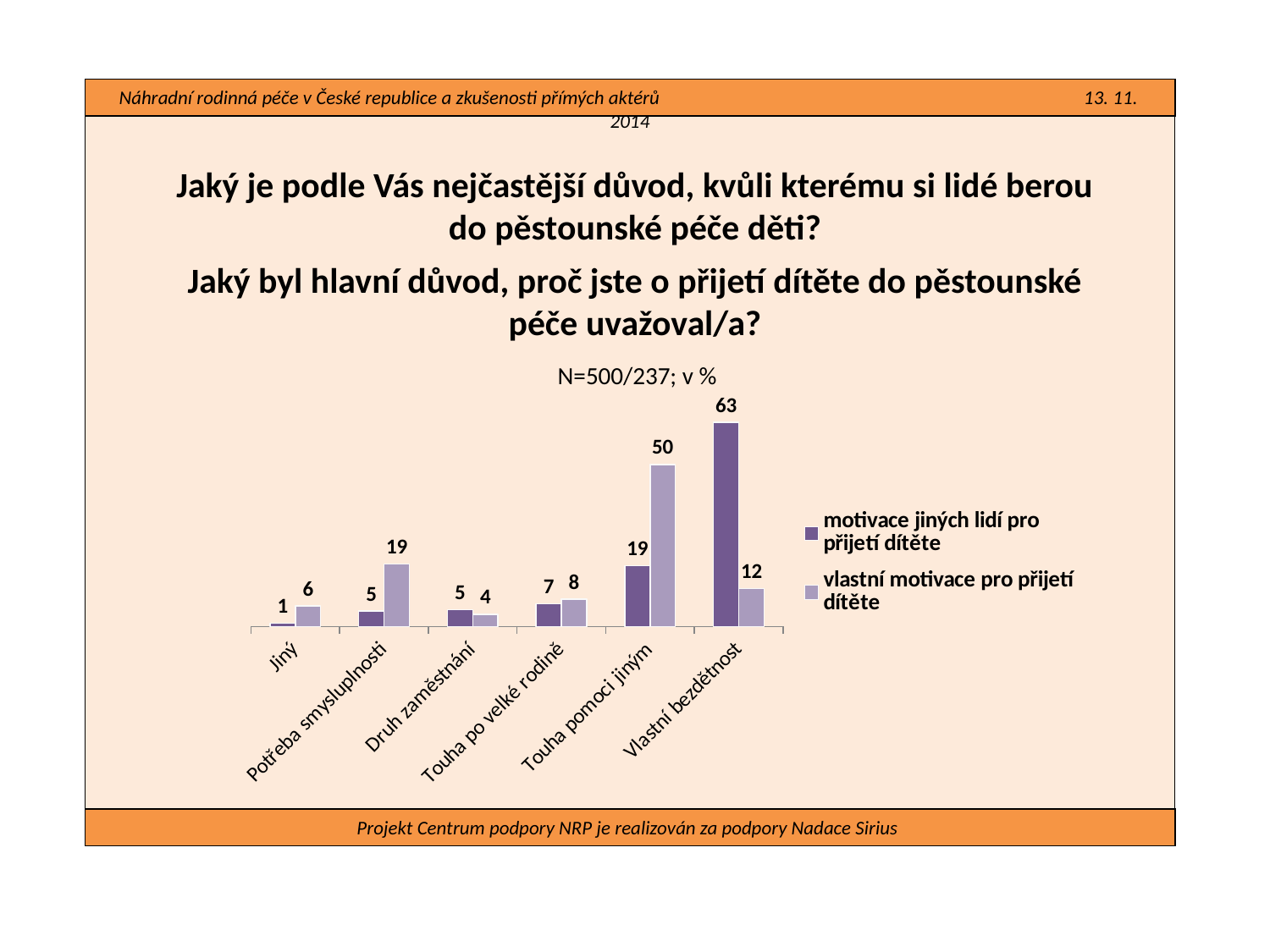
What is the value for 'Touha pomoci jiným' in the 'vlastní motivace pro přijetí dítěte' series? 50 Which category has the highest value in the 'motivace jiných lidí pro přijetí dítěte' series? Vlastní bezdětnost Which category has the lowest value in the 'vlastní motivace pro přijetí dítěte' series? Druh zaměstnání How many series does the legend list? 2 What is the value for 'Potřeba smysluplnosti' in the 'vlastní motivace pro přijetí dítěte' series? 19 How many categories are shown on the x axis? 6 What is the value for 'Vlastní bezdětnost' in the 'motivace jiných lidí pro přijetí dítěte' series? 63 What is the value for 'Jiný' in the 'motivace jiných lidí pro přijetí dítěte' series? 1 What is the difference between the two series for 'Vlastní bezdětnost'? 51 For 'Druh zaměstnání', which series has the larger value? motivace jiných lidí pro přijetí dítěte What kind of chart is shown on the slide? Bar chart What is the difference between the two series for 'Touha pomoci jiným'? 31